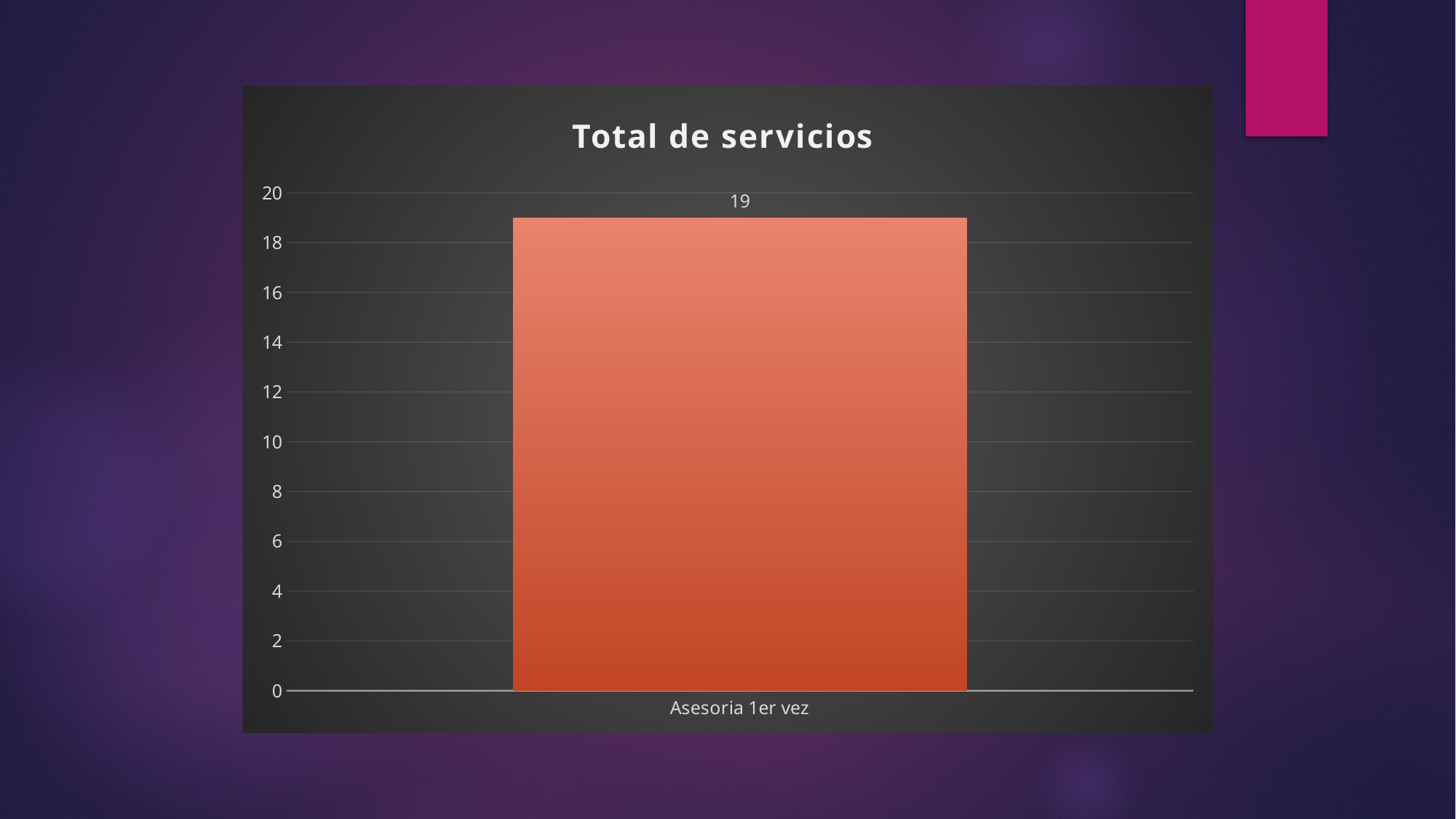
What is the label of the only category on the x axis? Asesoria 1er vez What kind of chart is shown on the slide? bar chart Is the value for Asesoria 1er vez greater or less than 10? greater What is the value for Asesoria 1er vez? 19 What is the title of the chart? Total de servicios How many categories are plotted in the chart? 1 What is the highest value shown on the vertical axis? 20 Is the value for Asesoria 1er vez greater or less than 20? less